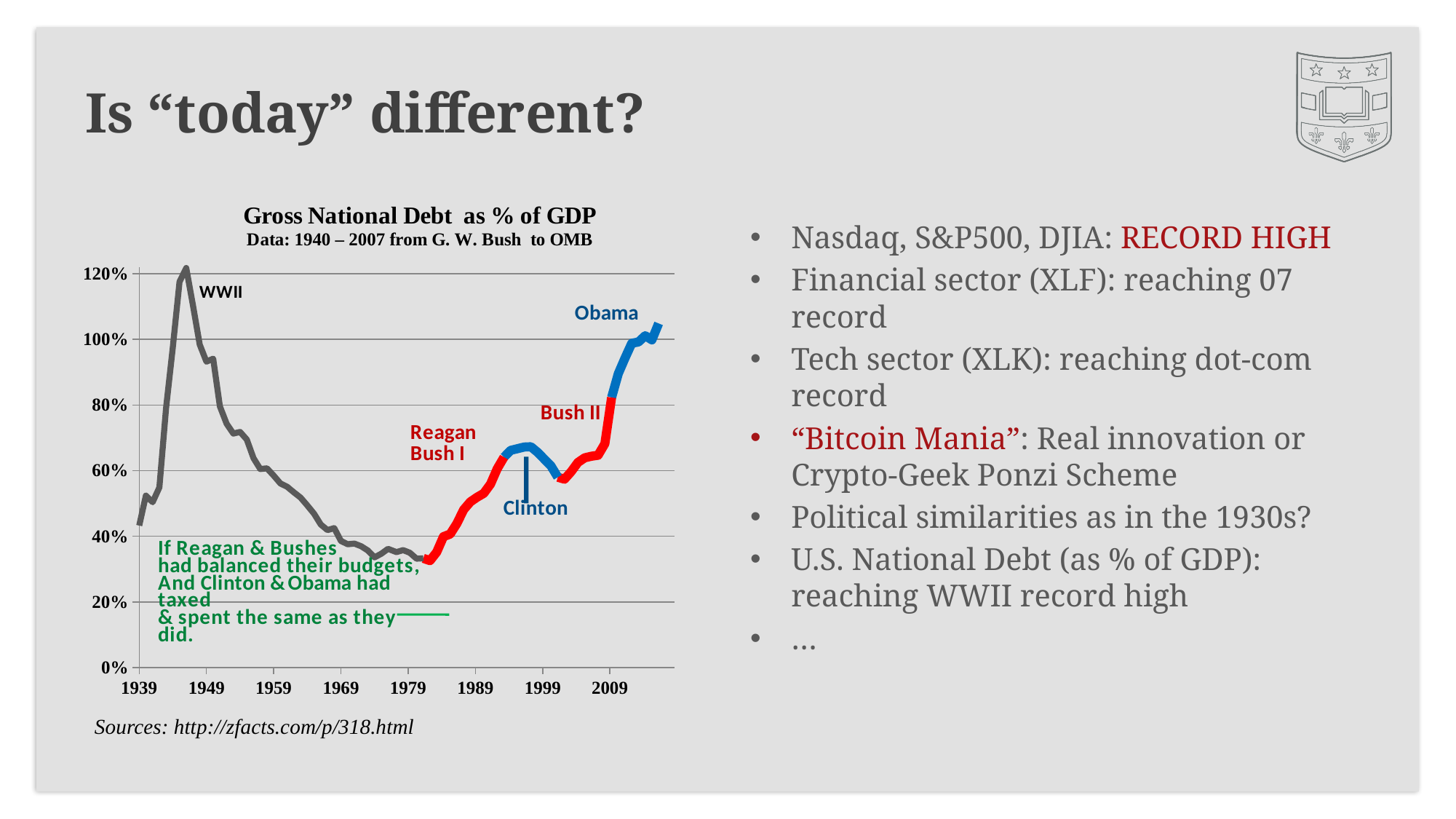
What is the title of the chart? Gross National Debt as % of GDP Is the peak value of the line during WWII greater or less than 100%? greater Does the line rise or fall between 1979 and 2009? rise What kind of chart is shown on the slide? line chart Which period is labelled at the highest point of the line? WWII Is the value at the end of the Bush II segment (around 2009) greater or less than 80%? greater What colour are the Clinton and Obama segments of the line? blue How many year labels are shown on the x axis? 8 Is the value at the start of the Reagan/Bush I segment (around 1981) greater or less than 40%? less Which is higher: the value at the WWII peak or the value at the end of the Obama segment? WWII peak Does the line rise or fall between the WWII peak and 1979? fall